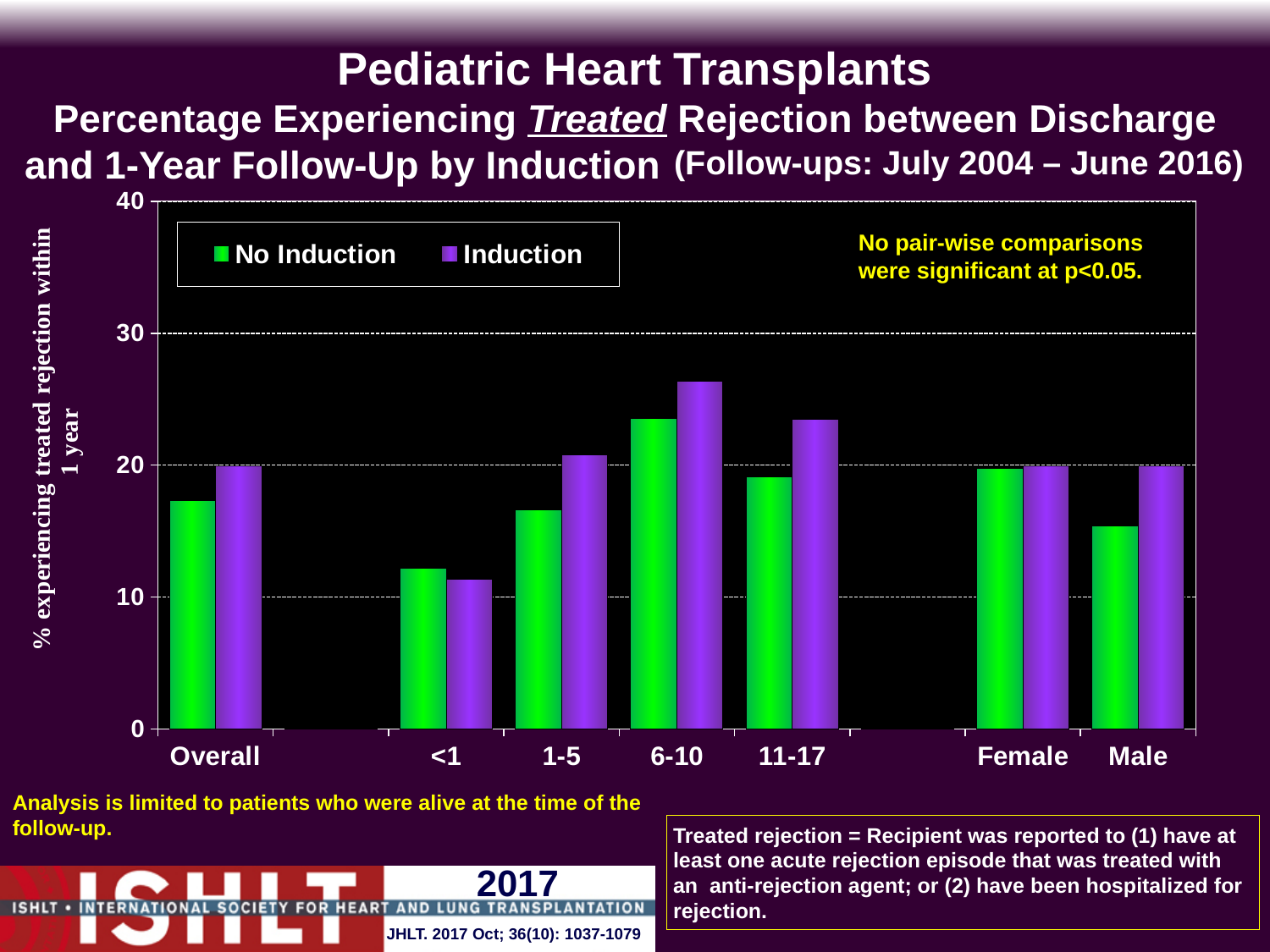
For the 1-5 age group, which is larger: No Induction or Induction? Induction Is the No Induction value for Male recipients greater or less than 20? less Is the Induction value for the 6-10 age group greater or less than 20? greater Which category has the lowest value for the No Induction series? <1 How many series does the legend list? 2 Which colour represents the No Induction series in the legend? green Which category has the lowest value for the Induction series? <1 What kind of chart is shown on the slide? bar chart For Male recipients, which is larger: No Induction or Induction? Induction Which category has the highest value for the No Induction series? 6-10 How many categories are shown along the x axis? 7 Which category has the highest value for the Induction series? 6-10